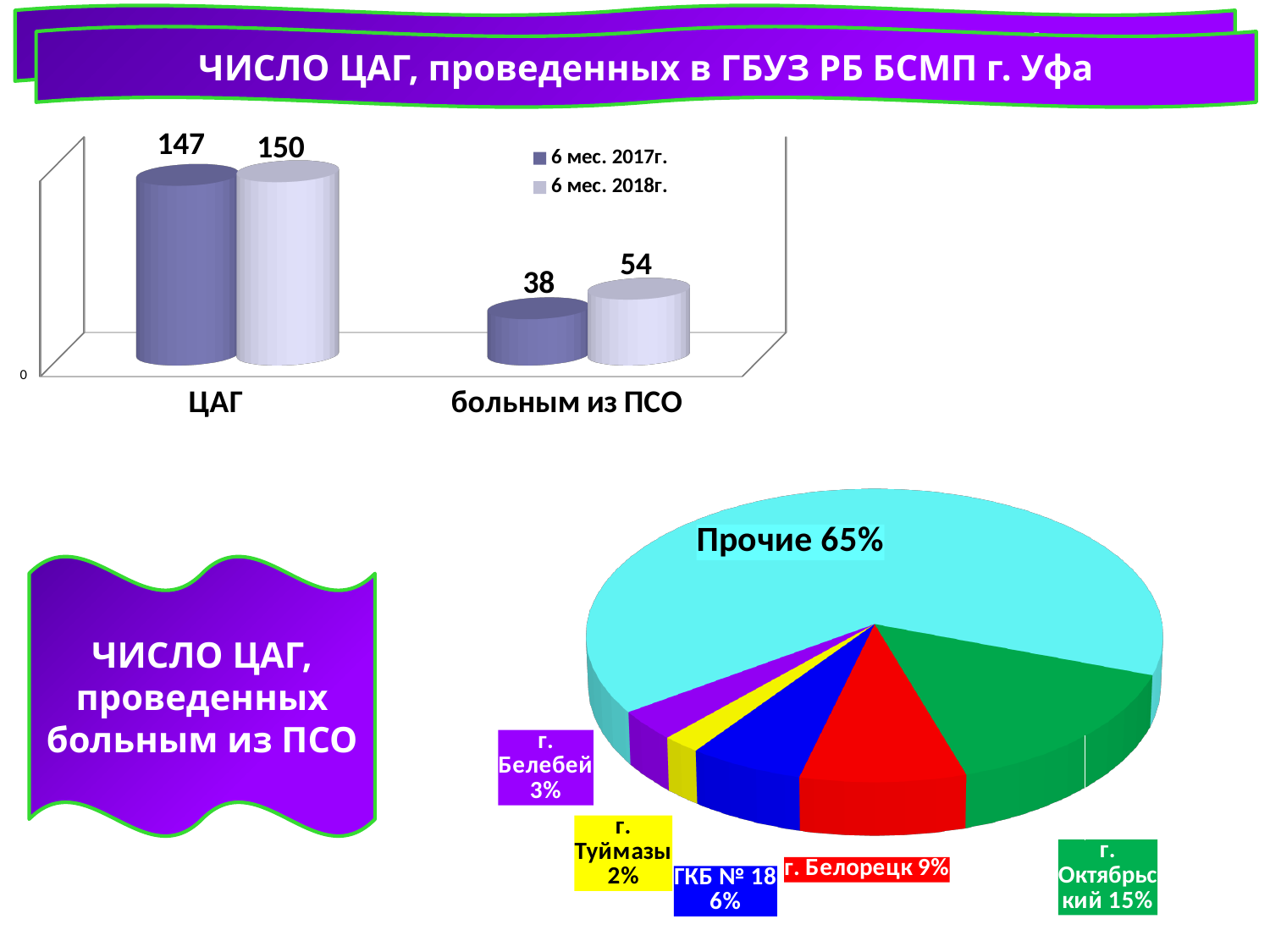
In the top bar chart, what is the value for ЦАГ in 6 мес. 2018г.? 150 In the top bar chart, which is larger for ЦАГ: 6 мес. 2017г. or 6 мес. 2018г.? 6 мес. 2018г. How many categories are shown on the x axis of the top bar chart? 2 How many series does the legend of the top bar chart list? 2 In the bottom pie chart, which slice is the smallest? г. Туймазы In the bottom pie chart, what share does г. Октябрьский have? 15% How many slices does the bottom pie chart have? 6 In the top bar chart, what is the value for больным из ПСО in 6 мес. 2017г.? 38 In the bottom pie chart, which is larger: г. Белорецк or ГКБ № 18? г. Белорецк In the top bar chart, what is the difference between the 6 мес. 2018г. and 6 мес. 2017г. values for больным из ПСО? 16 What kind of chart is the top chart on the slide? bar chart In the bottom pie chart, what share does Прочие have? 65%